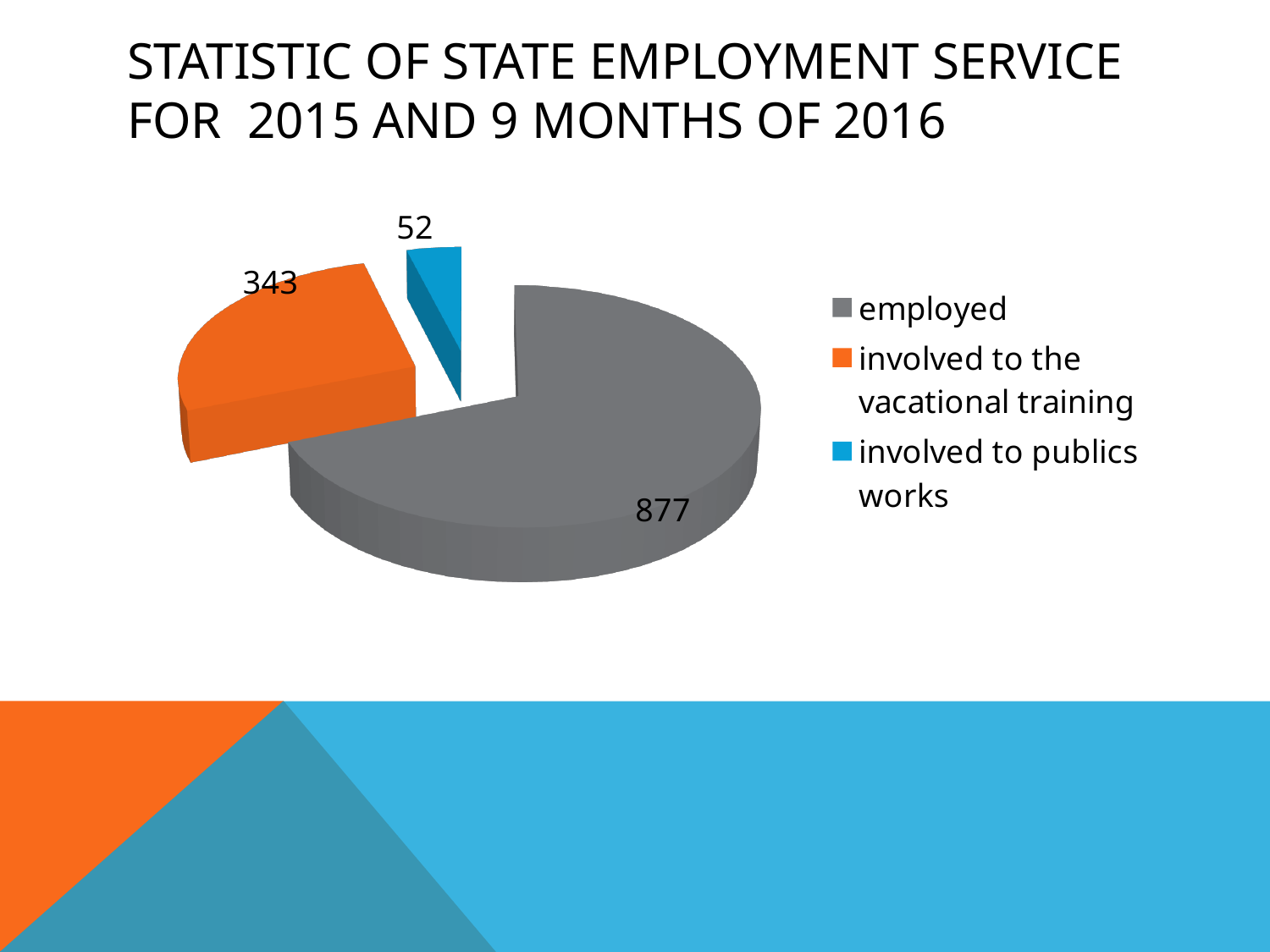
Which category has the smallest slice of the pie? involved to publics works What is the total of all three slices in the pie chart? 1272 What is the value for the slice labelled involved to the vacational training? 343 What is the difference between the employed value and the involved to the vacational training value? 534 What is the value for the employed slice? 877 Which category has the largest slice of the pie? employed What colour is the slice for involved to publics works? blue What is the difference between the involved to the vacational training value and the involved to publics works value? 291 What is the value for the slice labelled involved to publics works? 52 What kind of chart is shown on the slide? pie chart Which is larger, the value for involved to the vacational training or the value for involved to publics works? involved to the vacational training How many categories does the pie chart show? 3